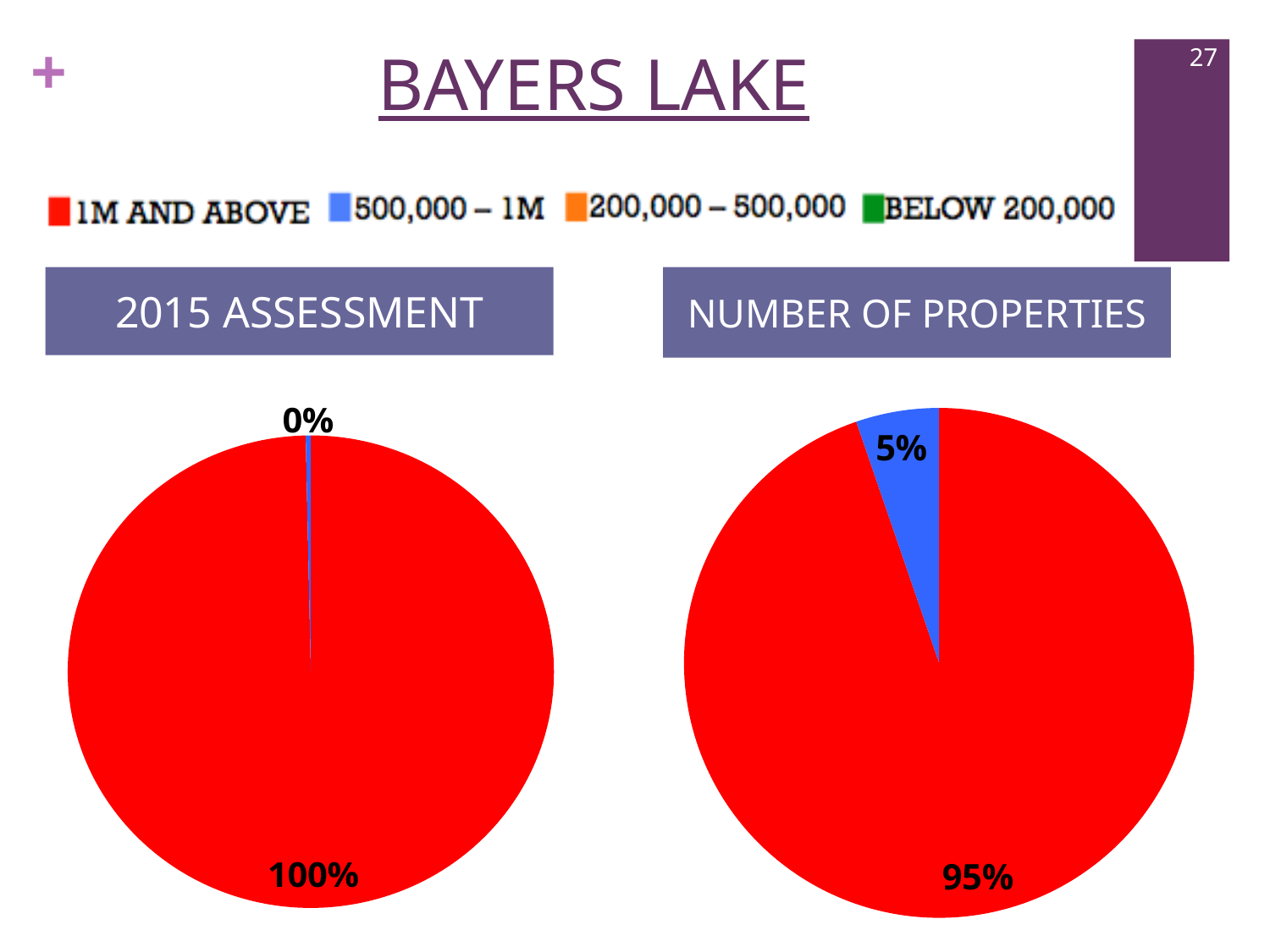
What type of chart is used for the 2015 ASSESSMENT? Pie chart What colour represents the 1M AND ABOVE category in the legend? Red How many categories does the legend at the top of the slide list? 4 In the NUMBER OF PROPERTIES pie chart, what share is labelled for the 1M AND ABOVE slice? 95% Which chart shows a larger share for 500,000 – 1M, the 2015 ASSESSMENT chart or the NUMBER OF PROPERTIES chart? NUMBER OF PROPERTIES In the NUMBER OF PROPERTIES pie chart, which labelled category has the smallest slice? 500,000 – 1M What is the title of the pie chart on the right side of the slide? NUMBER OF PROPERTIES In the NUMBER OF PROPERTIES pie chart, what is the difference between the 1M AND ABOVE share and the 500,000 – 1M share? 90% In the 2015 ASSESSMENT pie chart, what share is labelled for the 500,000 – 1M slice? 0% In the NUMBER OF PROPERTIES pie chart, which category has the largest slice? 1M AND ABOVE In the 2015 ASSESSMENT pie chart, what share is labelled for the 1M AND ABOVE slice? 100%